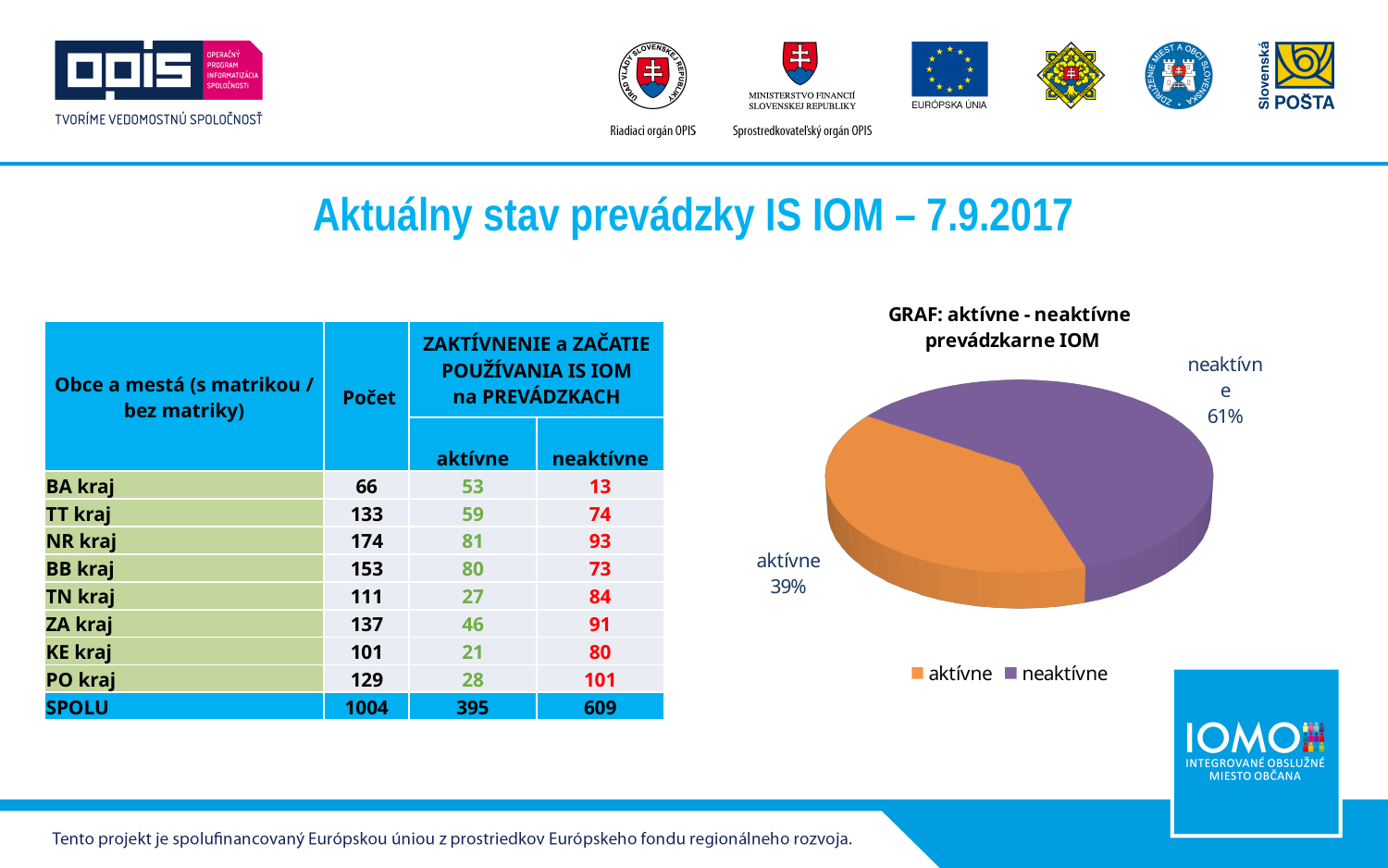
How many entries does the chart legend list? 2 What share of the pie does the 'aktívne' slice represent? 39% What share of the pie does the 'neaktívne' slice represent? 61% Which is larger in the pie chart, 'aktívne' or 'neaktívne'? neaktívne Which slice of the pie chart is the smallest? aktívne Is the share of the 'aktívne' slice greater or less than 50%? less What is the difference in percentage points between the 'neaktívne' and 'aktívne' slices? 22 What kind of chart is shown on the slide? pie chart What is the title of the pie chart? GRAF: aktívne - neaktívne prevádzkarne IOM Which colour is used for the 'neaktívne' slice in the pie chart? purple Which slice of the pie chart is the largest? neaktívne How many slices does the pie chart have? 2